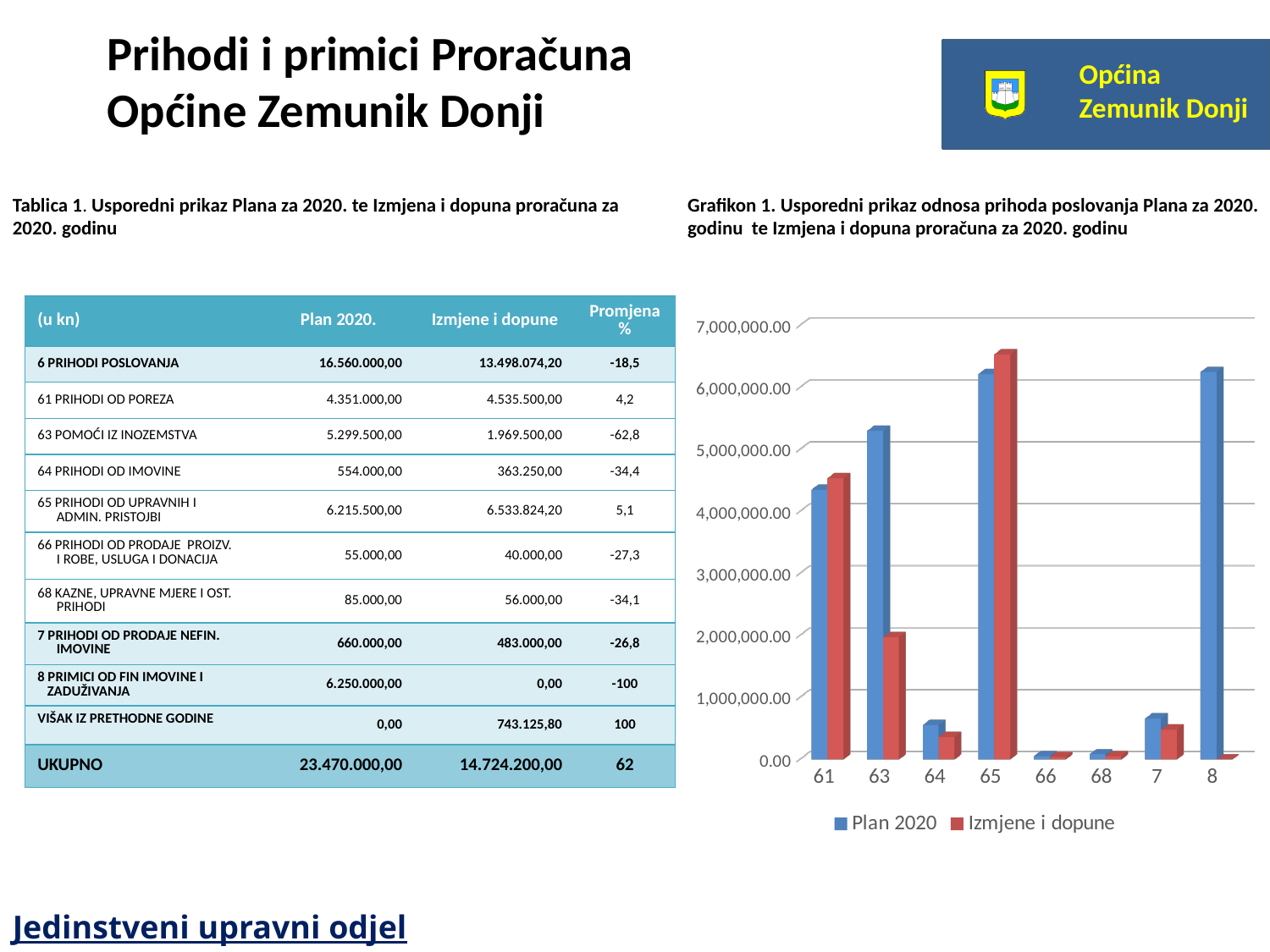
For category 65, which series has the larger value, Plan 2020 or Izmjene i dopune? Izmjene i dopune Is the Plan 2020 value for category 8 greater or less than 6,000,000.00? greater For category 8, which series has the larger value, Plan 2020 or Izmjene i dopune? Plan 2020 Which series is shown in red in the chart? Izmjene i dopune For category 63, which series has the larger value, Plan 2020 or Izmjene i dopune? Plan 2020 How many categories are shown on the x axis of the chart? 8 Which category has the highest value for the Izmjene i dopune series? 65 Is the Plan 2020 value for category 63 greater or less than 5,000,000.00? greater Is the Izmjene i dopune value for category 65 greater or less than 6,000,000.00? greater What kind of chart is Grafikon 1? bar chart How many series does the chart's legend list? 2